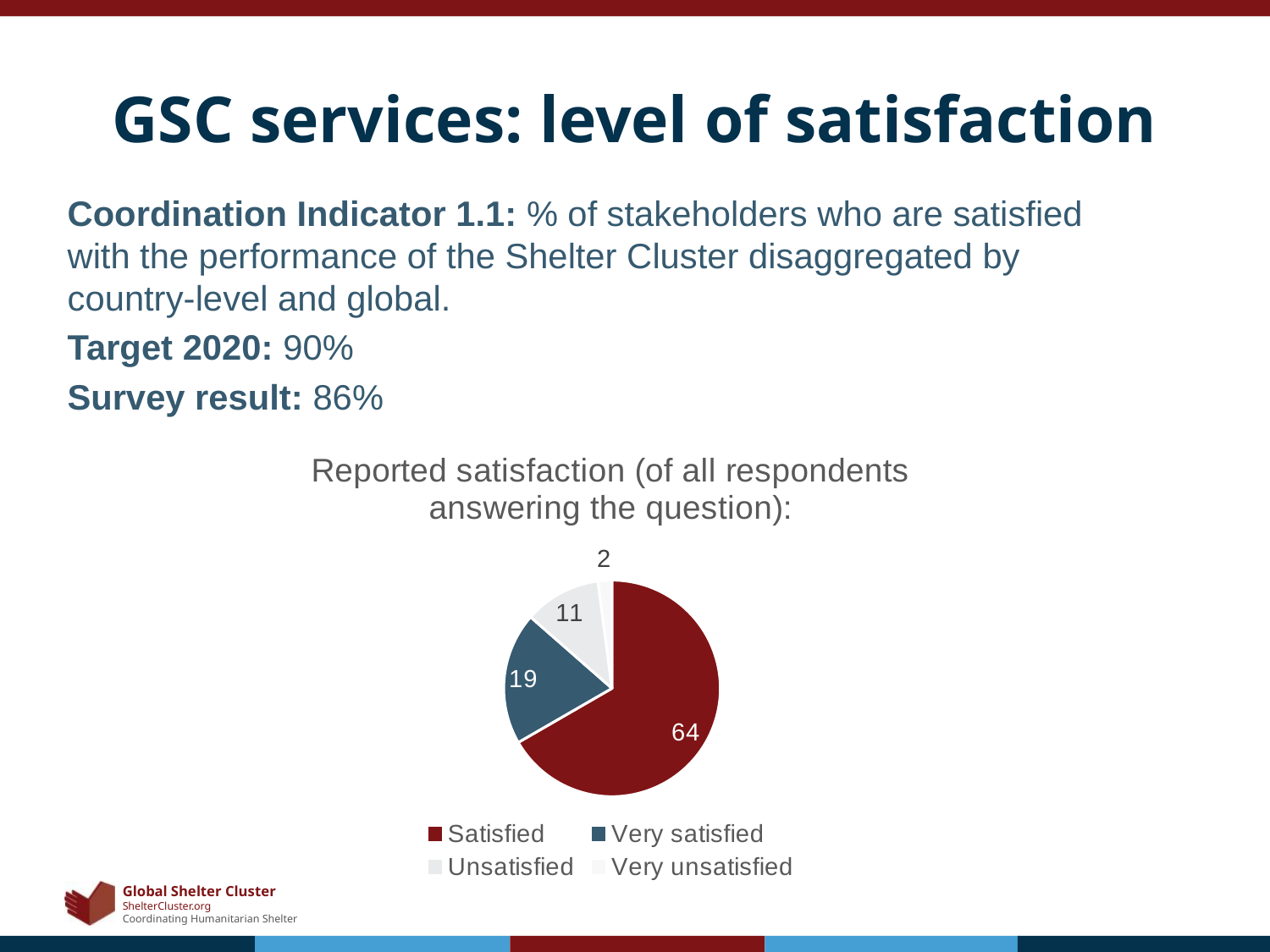
What is the value for the Unsatisfied slice in the pie chart? 11 What type of chart is shown on the slide? pie chart What is the value for the Very satisfied slice in the pie chart? 19 Which category has the largest slice in the pie chart? Satisfied How many categories does the pie chart legend list? 4 Which category has the smallest slice in the pie chart? Very unsatisfied What is the difference between the Unsatisfied and Very unsatisfied values in the pie chart? 9 What is the title of the pie chart? Reported satisfaction (of all respondents answering the question): What is the value for the Very unsatisfied slice in the pie chart? 2 Which is larger in the pie chart, Very satisfied or Unsatisfied? Very satisfied What is the difference between the Satisfied and Very satisfied values in the pie chart? 45 What is the value for the Satisfied slice in the pie chart? 64